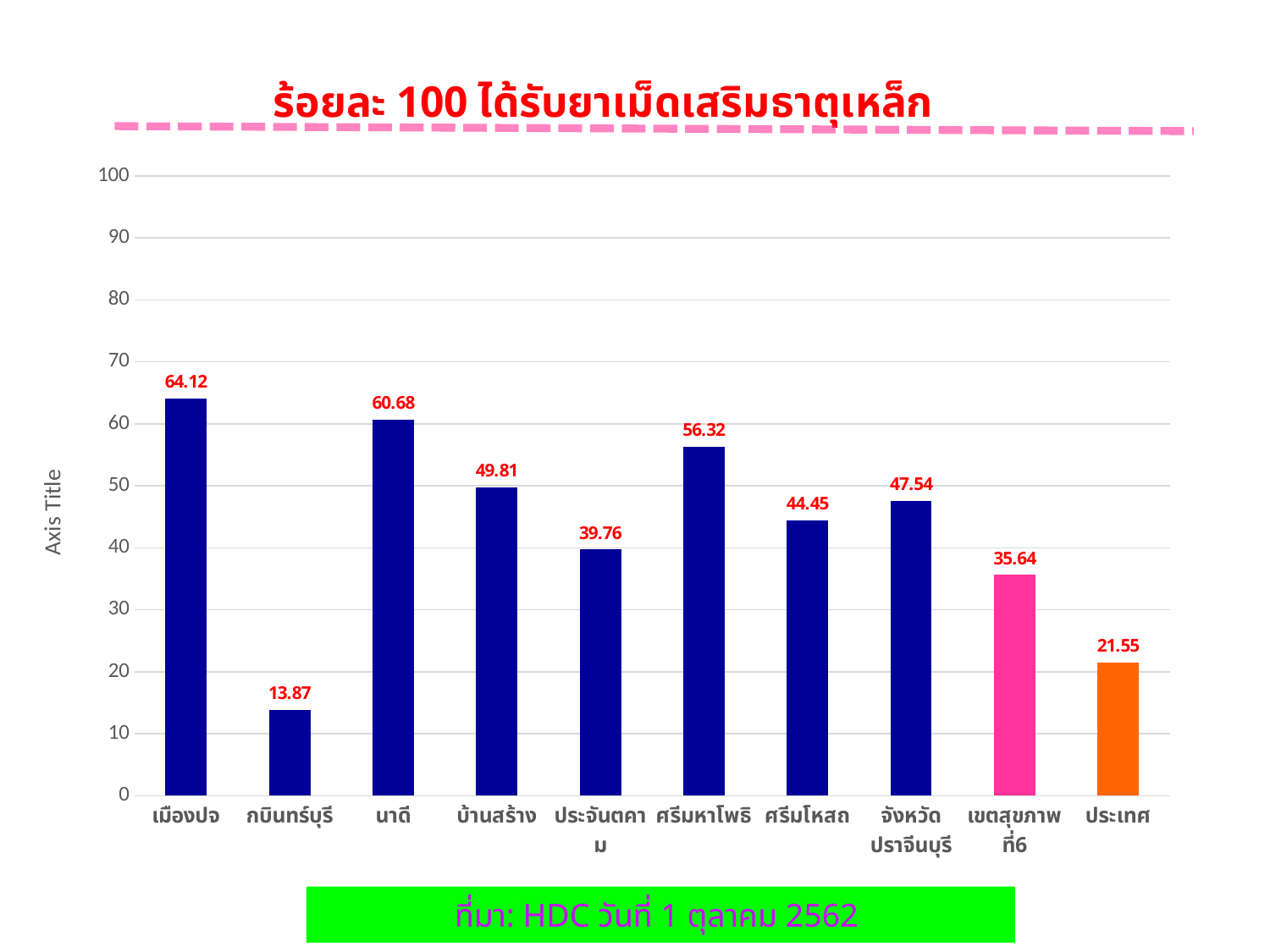
What is the title of the chart? ร้อยละ 100 ได้รับยาเม็ดเสริมธาตุเหล็ก What is the value for เมืองปจ? 64.12 Which is larger, the value for นาดี or the value for ศรีมหาโพธิ? นาดี Is the value for บ้านสร้าง greater or less than 40? greater What kind of chart is shown on the slide? bar chart How many categories are shown on the x axis? 10 Which category has the lowest value? กบินทร์บุรี Which category has the highest value? เมืองปจ What is the difference between the values for จังหวัดปราจีนบุรี and ประเทศ? 25.99 What is the value for ประเทศ? 21.55 What is the difference between the values for เมืองปจ and กบินทร์บุรี? 50.25 What is the value for เขตสุขภาพที่6? 35.64